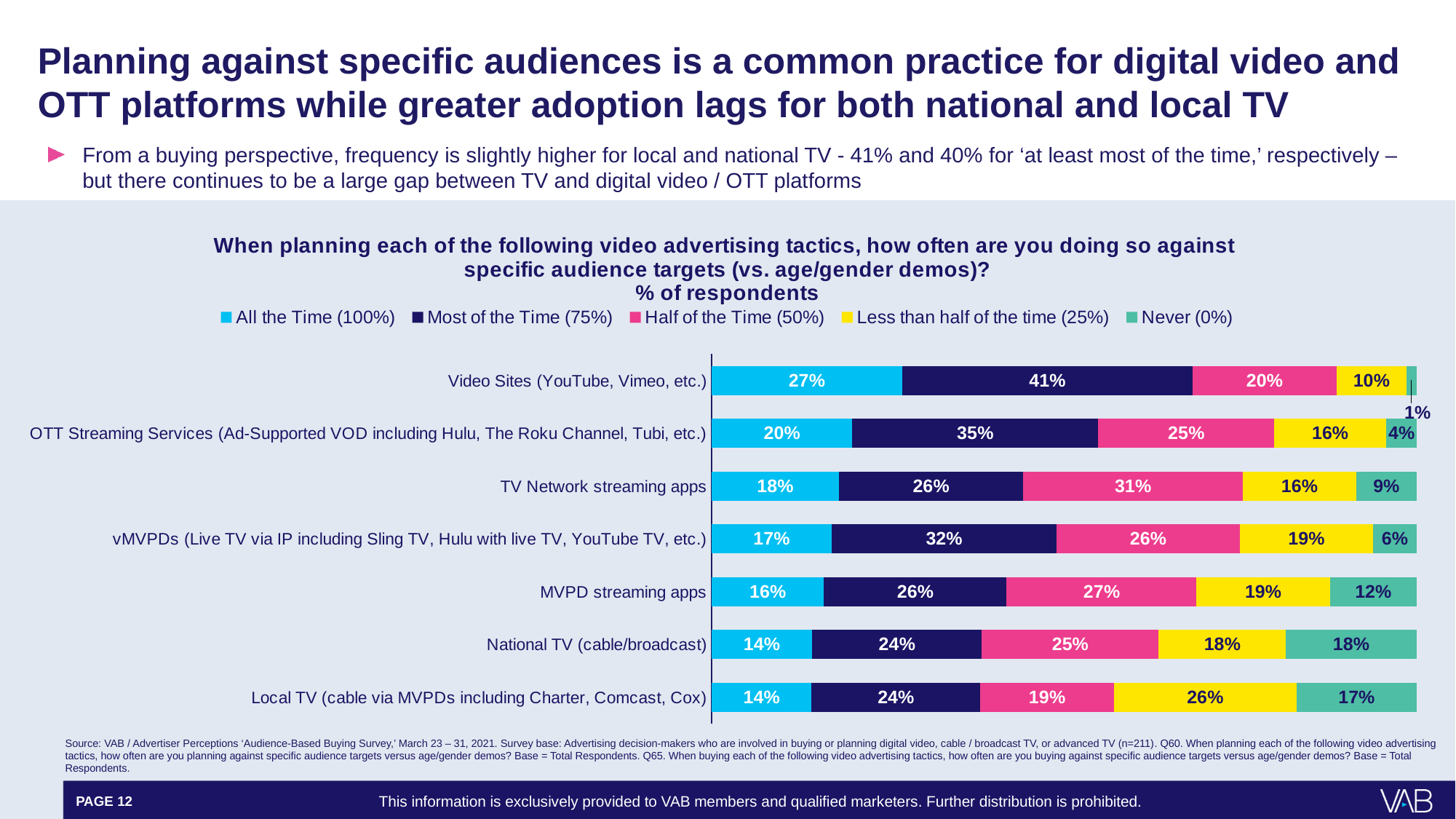
How many series does the legend list? 5 What is the difference between the 'Most of the Time (75%)' values for Video Sites and Local TV? 17% What is the 'Never (0%)' value for National TV (cable/broadcast)? 18% How many categories (video advertising tactics) are shown in the chart? 7 Which legend entry is shown in yellow? Less than half of the time (25%) What is the total of the stacked bar for OTT Streaming Services? 100% What is the 'Half of the Time (50%)' value for TV Network streaming apps? 31% Which is larger: the 'Less than half of the time (25%)' value for Local TV or for National TV? Local TV What kind of chart is shown on the slide? Stacked bar chart Which category has the highest 'All the Time (100%)' value? Video Sites (YouTube, Vimeo, etc.) What percentage of respondents plan against specific audience targets 'All the Time' for Video Sites (YouTube, Vimeo, etc.)? 27% Which category has the lowest 'Never (0%)' value? Video Sites (YouTube, Vimeo, etc.)